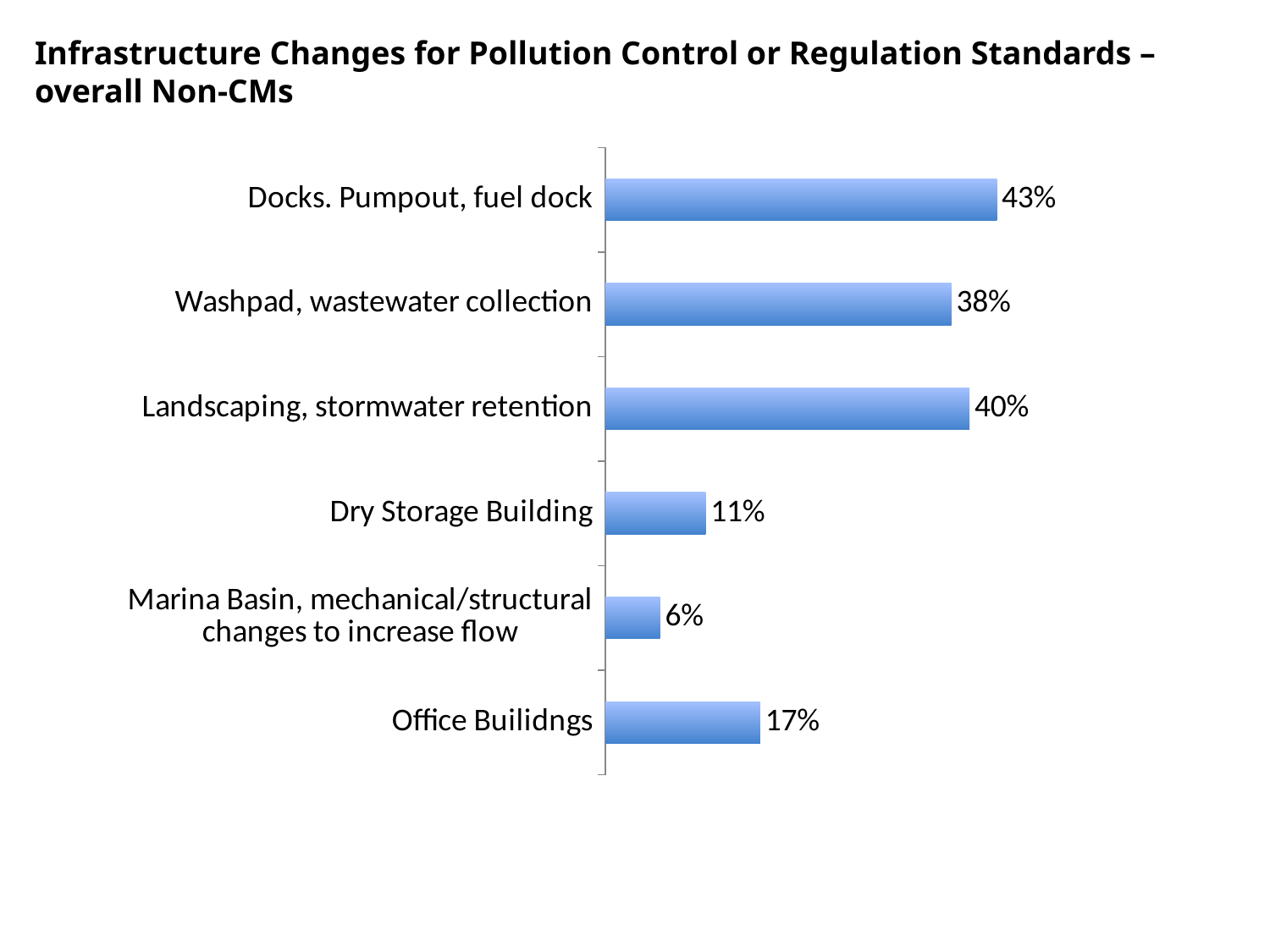
What is the value for Dry Storage Building? 11% Which category has the highest value? Docks. Pumpout, fuel dock How many categories are shown in the chart? 6 What is the difference between the values for Docks. Pumpout, fuel dock and Washpad, wastewater collection? 5% What is the value for Docks. Pumpout, fuel dock? 43% What kind of chart is shown on the slide? Bar chart What is the value for Office Builidngs? 17% Which category has the lowest value? Marina Basin, mechanical/structural changes to increase flow What is the value for Marina Basin, mechanical/structural changes to increase flow? 6% What is the value for Washpad, wastewater collection? 38% Which is larger, the value for Office Builidngs or the value for Dry Storage Building? Office Builidngs What is the value for Landscaping, stormwater retention? 40%